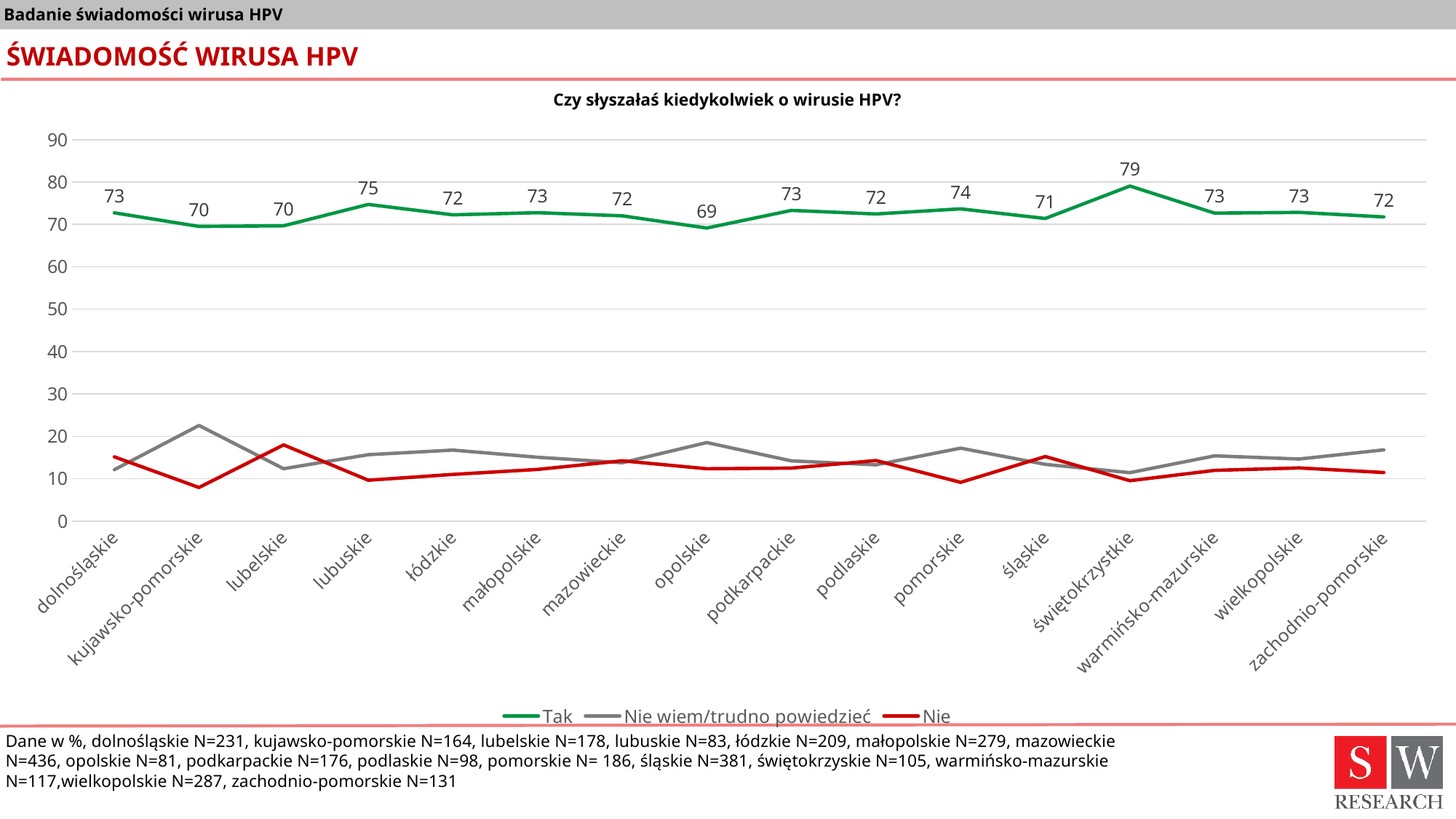
Is the value of the 'Nie' series for kujawsko-pomorskie greater or less than 10? less What is the difference between the 'Tak' values for świętokrzyskie and opolskie? 10 Is the value of the 'Nie wiem/trudno powiedzieć' series for kujawsko-pomorskie greater or less than 20? greater Which voivodeship has the lowest value in the 'Tak' series? opolskie How many voivodeships (categories) are shown on the x axis? 16 Which voivodeship has the highest value in the 'Tak' series? świętokrzyskie How many series does the legend list? 3 What is the value of the 'Tak' series for opolskie? 69 What is the value of the 'Tak' series for lubuskie? 75 What is the value of the 'Tak' series for świętokrzyskie? 79 What type of chart is shown on the slide? line chart Which has a larger 'Tak' value: pomorskie or śląskie? pomorskie